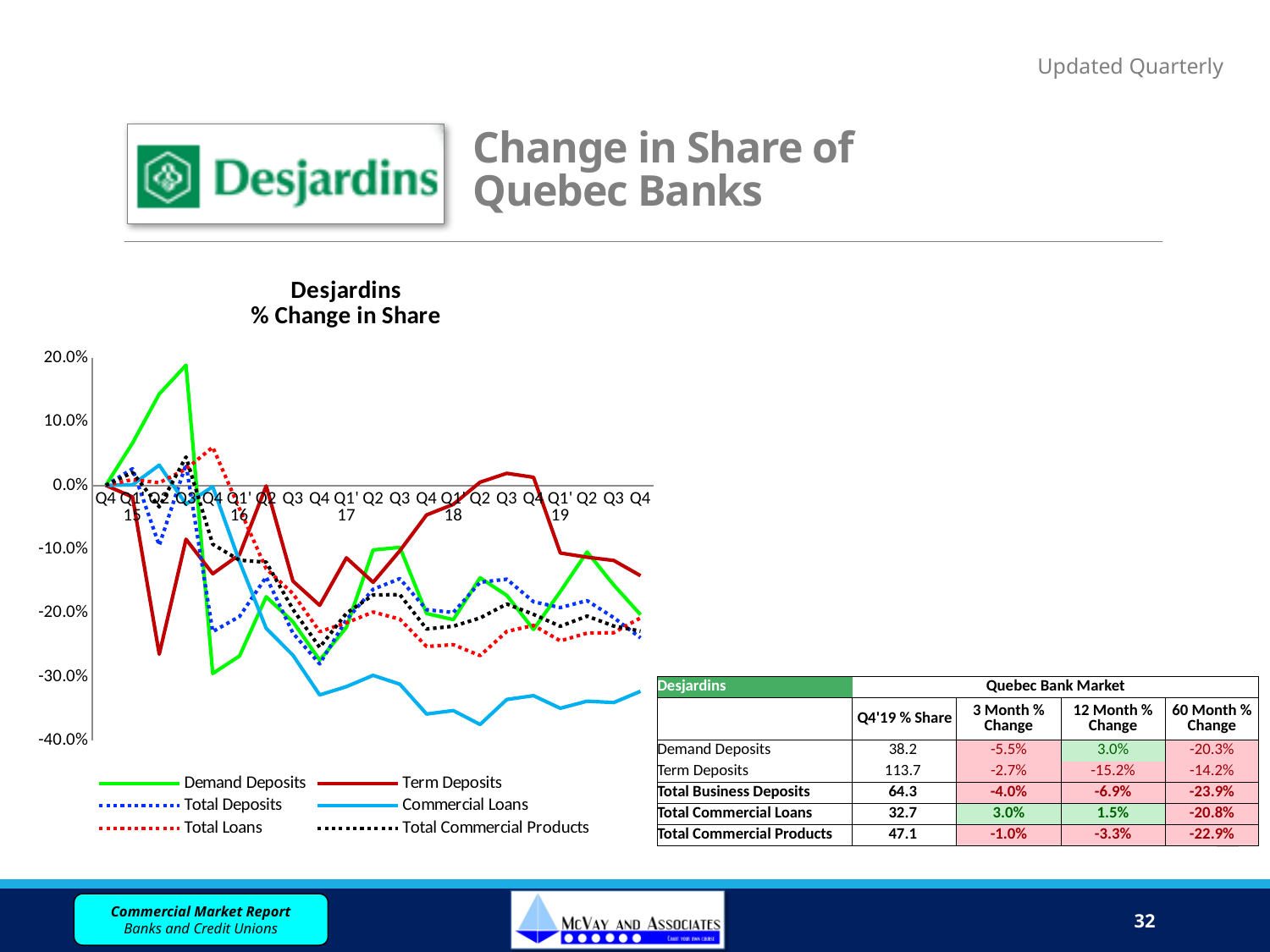
How many quarterly points are plotted along the x axis of the "Desjardins % Change in Share" chart? 21 How many series does the legend of the "Desjardins % Change in Share" chart list? 6 In the "Desjardins % Change in Share" chart, which series has the highest value at Q3'15? Demand Deposits In the "Desjardins % Change in Share" chart, at Q4'19 which is larger, Term Deposits or Commercial Loans? Term Deposits In the "Desjardins % Change in Share" chart, is the value for Commercial Loans at Q4'18 greater or less than -30.0%? less What kind of chart is the "Desjardins % Change in Share" chart? line chart What colour is the Term Deposits line in the "Desjardins % Change in Share" chart? dark red In the "Desjardins % Change in Share" chart, which series has the lowest value at Q4'19? Commercial Loans In the "Desjardins % Change in Share" chart, is the value for Commercial Loans at Q4'19 greater or less than -20.0%? less In the "Desjardins % Change in Share" chart, is the value for Demand Deposits at Q3'15 greater or less than 10.0%? greater In the "Desjardins % Change in Share" chart, does the Commercial Loans series generally rise or fall from Q4'14 to Q4'19? fall